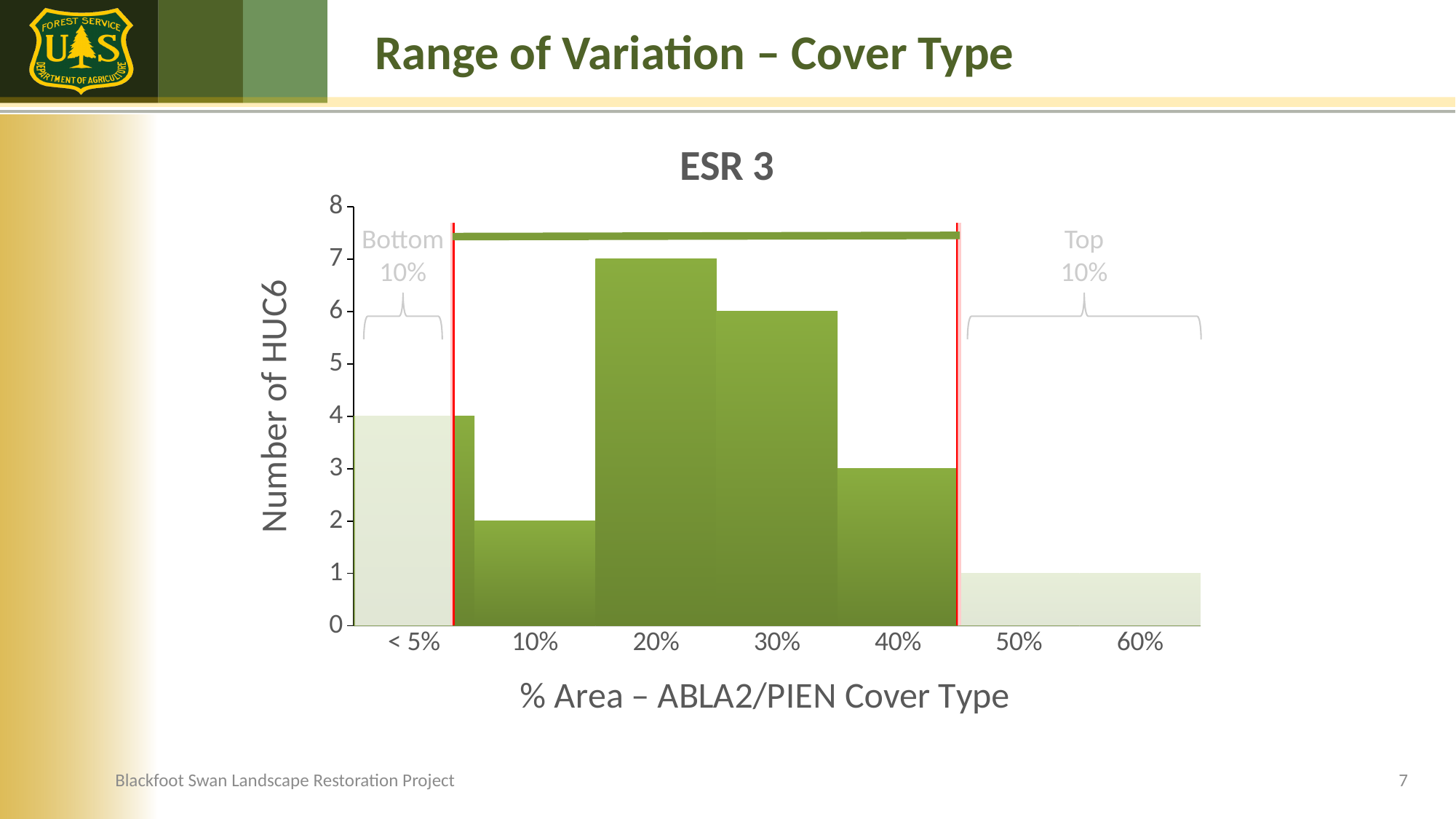
Which category has a larger number of HUC6, 30% or 40%? 30% What is the number of HUC6 for the 40% category? 3 What is the number of HUC6 for the < 5% category? 4 What is the y-axis title of the chart? Number of HUC6 What type of chart is shown on the slide? bar chart Which category has the highest number of HUC6? 20% What is the number of HUC6 for the 20% category? 7 Is the value for the 10% category greater or less than 3? less What is the difference in number of HUC6 between the 20% and 10% categories? 5 What is the number of HUC6 for the 30% category? 6 What is the title of the chart? ESR 3 How many categories are shown on the x axis of the chart? 7